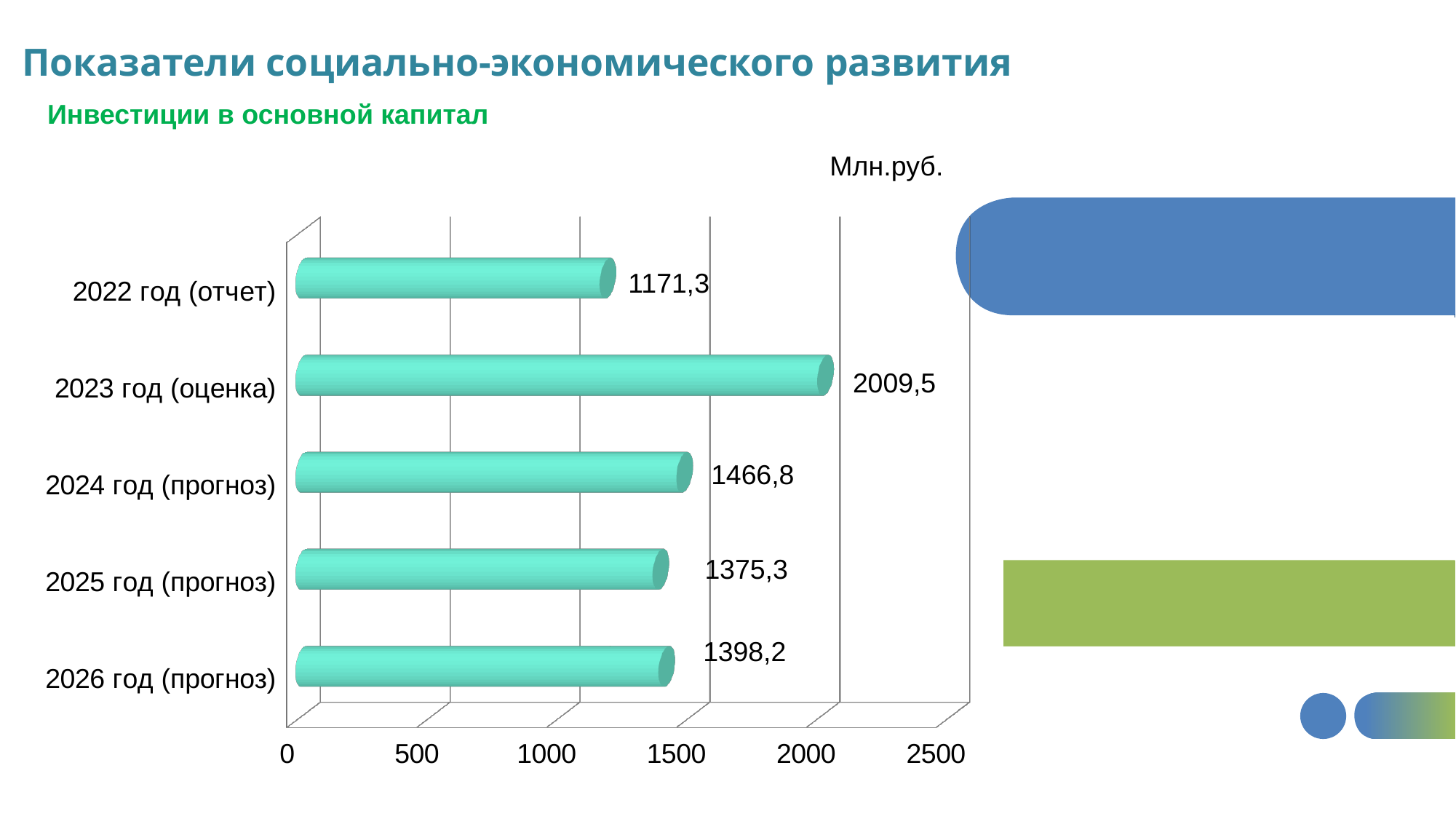
What kind of chart is shown on the slide? bar chart What is the value for 2025 год (прогноз)? 1375,3 Which category has the highest value? 2023 год (оценка) What is the value for 2022 год (отчет)? 1171,3 How many categories are shown in the chart? 5 What unit is indicated for the chart values? Млн.руб. What is the difference between the values for 2023 год (оценка) and 2022 год (отчет)? 838,2 Is the value for 2024 год (прогноз) greater or less than 1500? less What is the difference between the values for 2024 год (прогноз) and 2025 год (прогноз)? 91,5 Which is larger, the value for 2025 год (прогноз) or 2026 год (прогноз)? 2026 год (прогноз) What is the value for 2023 год (оценка)? 2009,5 Which category has the lowest value? 2022 год (отчет)